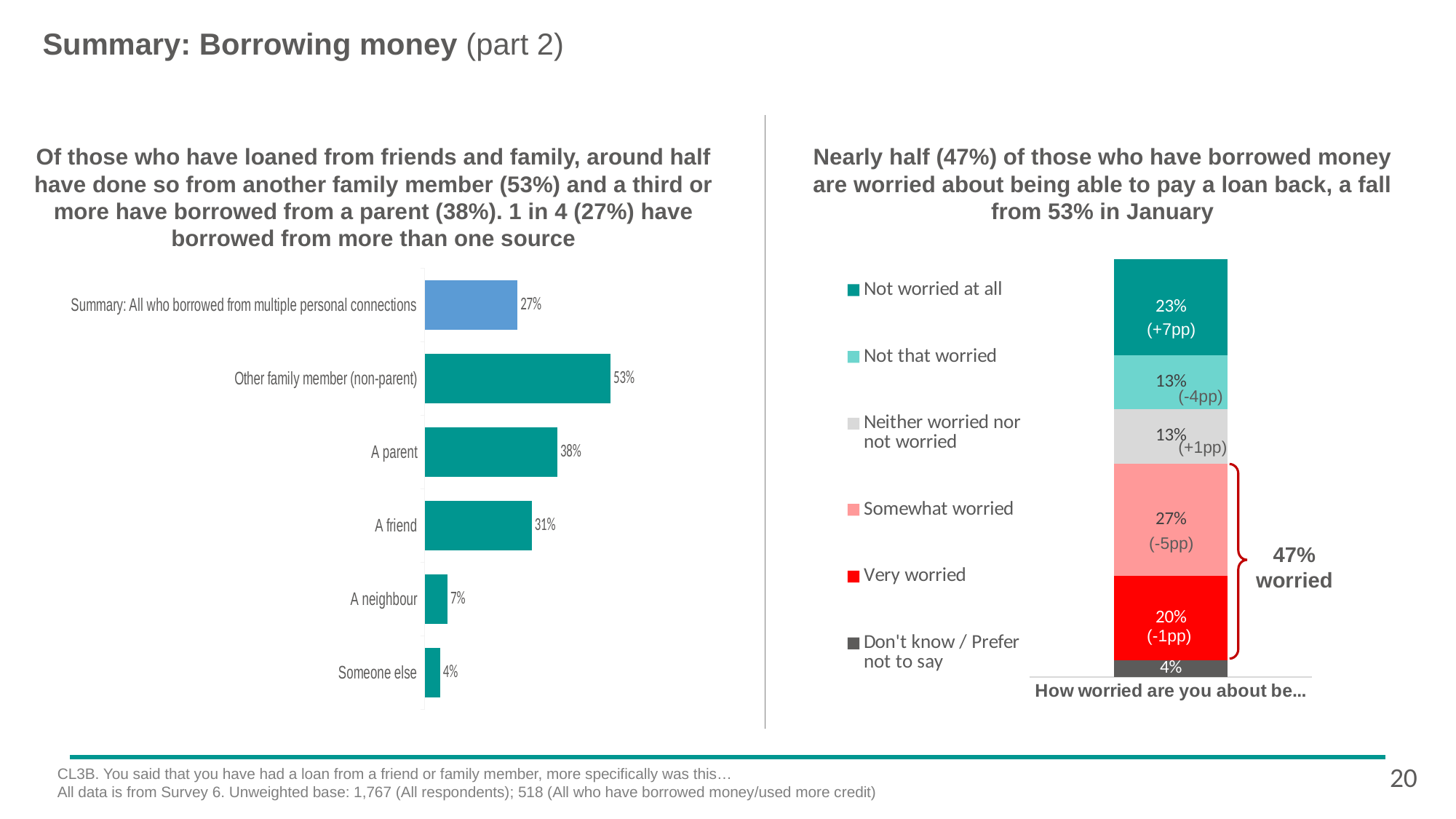
How many series does the legend of the right chart list? 6 In the left chart, what is the difference between the percentage for 'A parent' and the percentage for 'A friend'? 7% In the left chart, which source has the lowest percentage? Someone else In the right chart, what is the total of the stacked bar? 100% In the left chart, what percentage borrowed from a neighbour? 7% In the left chart, which is larger: the value for 'A friend' or the value for 'Summary: All who borrowed from multiple personal connections'? A friend In the right chart, what percentage are 'Somewhat worried'? 27% In the right chart, what percentage are 'Not worried at all'? 23% How many categories are shown in the left chart? 6 What type of chart is the left chart? Bar chart In the left chart, which source has the highest percentage? Other family member (non-parent) In the left chart, what percentage borrowed from another family member (non-parent)? 53%